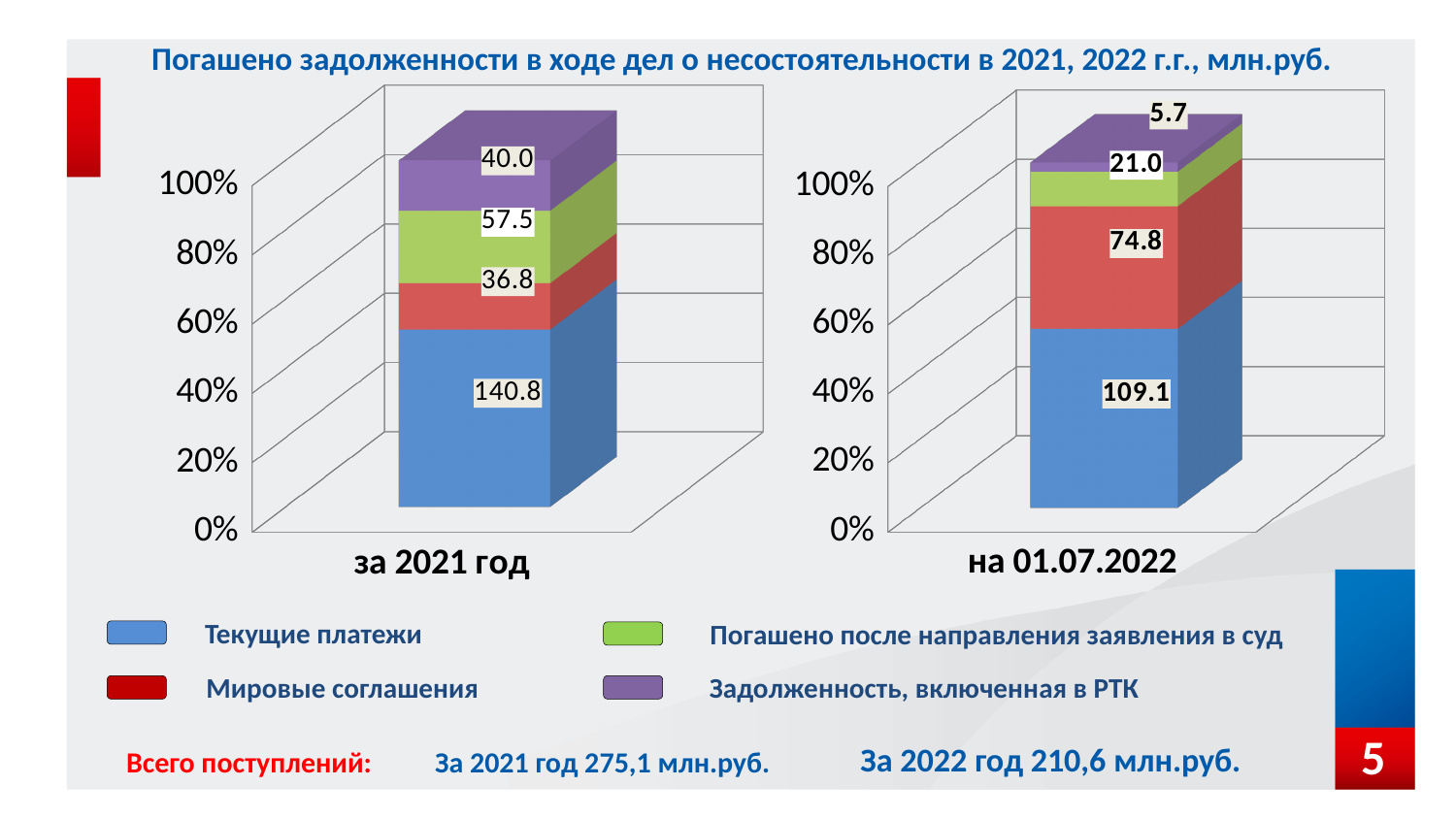
Which is larger: Мировые соглашения in the left chart (за 2021 год) or in the right chart (на 01.07.2022)? на 01.07.2022 What kind of chart is shown on the slide? Stacked bar chart In the right chart (на 01.07.2022), what is the value for Мировые соглашения? 74.8 What is the total of the stacked bar in the right chart (на 01.07.2022)? 210.6 In the right chart (на 01.07.2022), which category has the smallest value? Задолженность, включенная в РТК What is the difference between Текущие платежи in the left chart (за 2021 год) and in the right chart (на 01.07.2022)? 31.7 In the left chart (за 2021 год), what is the value for Текущие платежи? 140.8 In the left chart (за 2021 год), what is the value for Погашено после направления заявления в суд? 57.5 In the left chart (за 2021 год), which category has the largest value? Текущие платежи What is the total of the stacked bar in the left chart (за 2021 год)? 275.1 How many series does the legend list? 4 In the right chart (на 01.07.2022), what is the value for Задолженность, включенная в РТК? 5.7